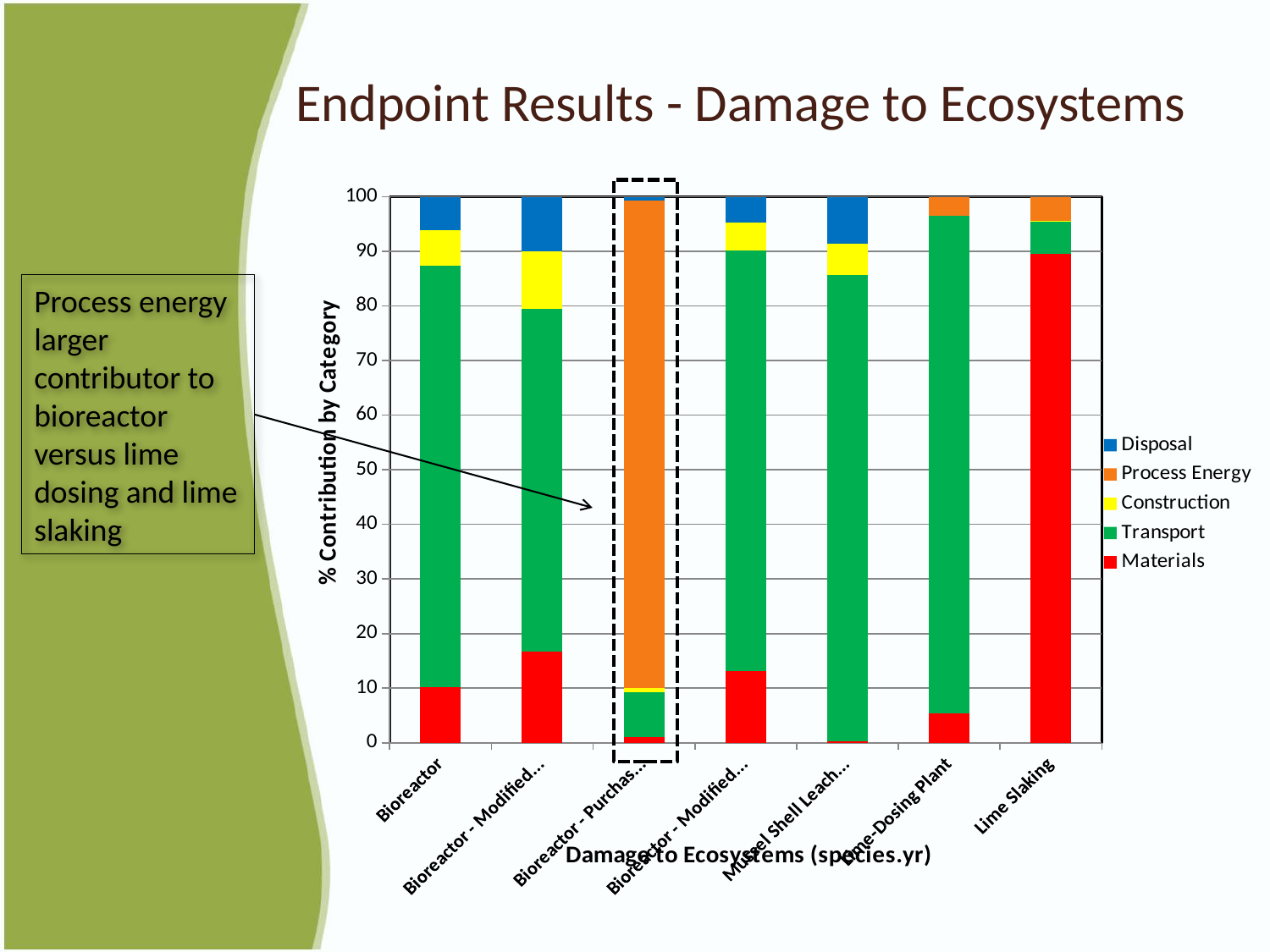
Is the Materials contribution for Lime Slaking greater or less than 80? greater What is the label of the vertical axis? % Contribution by Category How many bars (categories) are plotted on the chart? 7 How many series does the legend list? 5 Is the Materials contribution for Lime-Dosing Plant greater or less than 10? less Which bar has the largest Process Energy (orange) contribution? The third bar from the left (Bioreactor - Purchas...) Which category has the largest Materials (red) contribution? Lime Slaking What is the total height of the Bioreactor stacked bar? 100 Which has the larger Materials contribution, Bioreactor or Lime Slaking? Lime Slaking Is the Materials contribution for Bioreactor greater or less than 20? less What kind of chart is shown on the slide? Stacked bar chart Which series is shown in orange in the legend? Process Energy